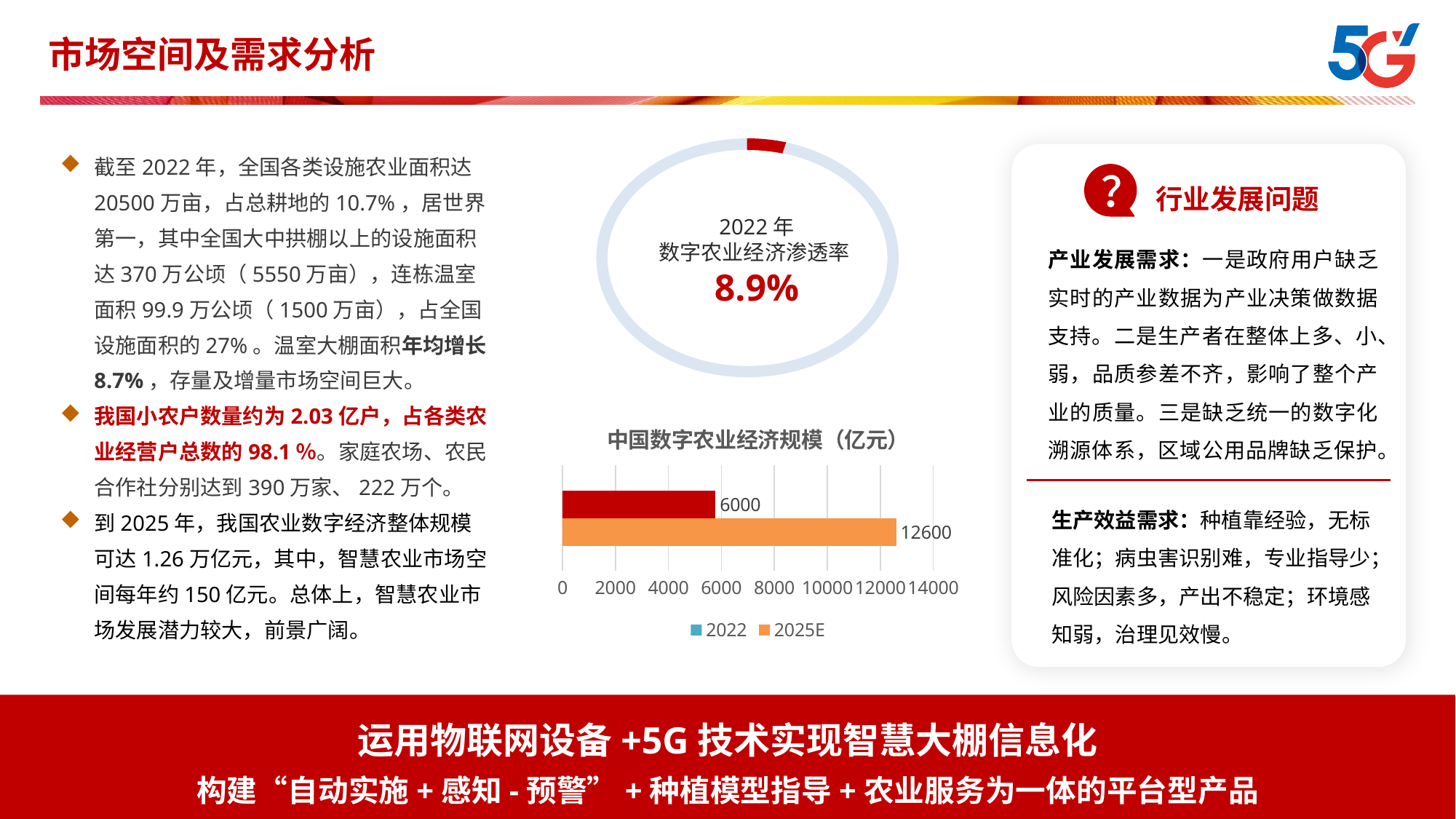
What percentage is shown in the centre of the donut chart in the middle of the slide? 8.9% In the chart titled 中国数字农业经济规模（亿元）, what is the maximum value shown on the horizontal axis? 14000 In the chart titled 中国数字农业经济规模（亿元）, what is the value for 2025E? 12600 What kind of chart is the chart titled 中国数字农业经济规模（亿元）? bar chart How many series does the legend of the chart titled 中国数字农业经济规模（亿元） list? 2 In the chart titled 中国数字农业经济规模（亿元）, is the value for 2025E greater or less than 12000? greater In the chart titled 中国数字农业经济规模（亿元）, is the value for 2022 greater or less than 8000? less In the chart titled 中国数字农业经济规模（亿元）, what is the value for 2022? 6000 What kind of chart is the chart in the upper middle of the slide showing 2022 年数字农业经济渗透率? donut chart In the chart titled 中国数字农业经济规模（亿元）, what is the difference between the 2025E value and the 2022 value? 6600 In the chart titled 中国数字农业经济规模（亿元）, which series has the higher value, 2022 or 2025E? 2025E What is the title of the bar chart in the lower middle of the slide? 中国数字农业经济规模（亿元）